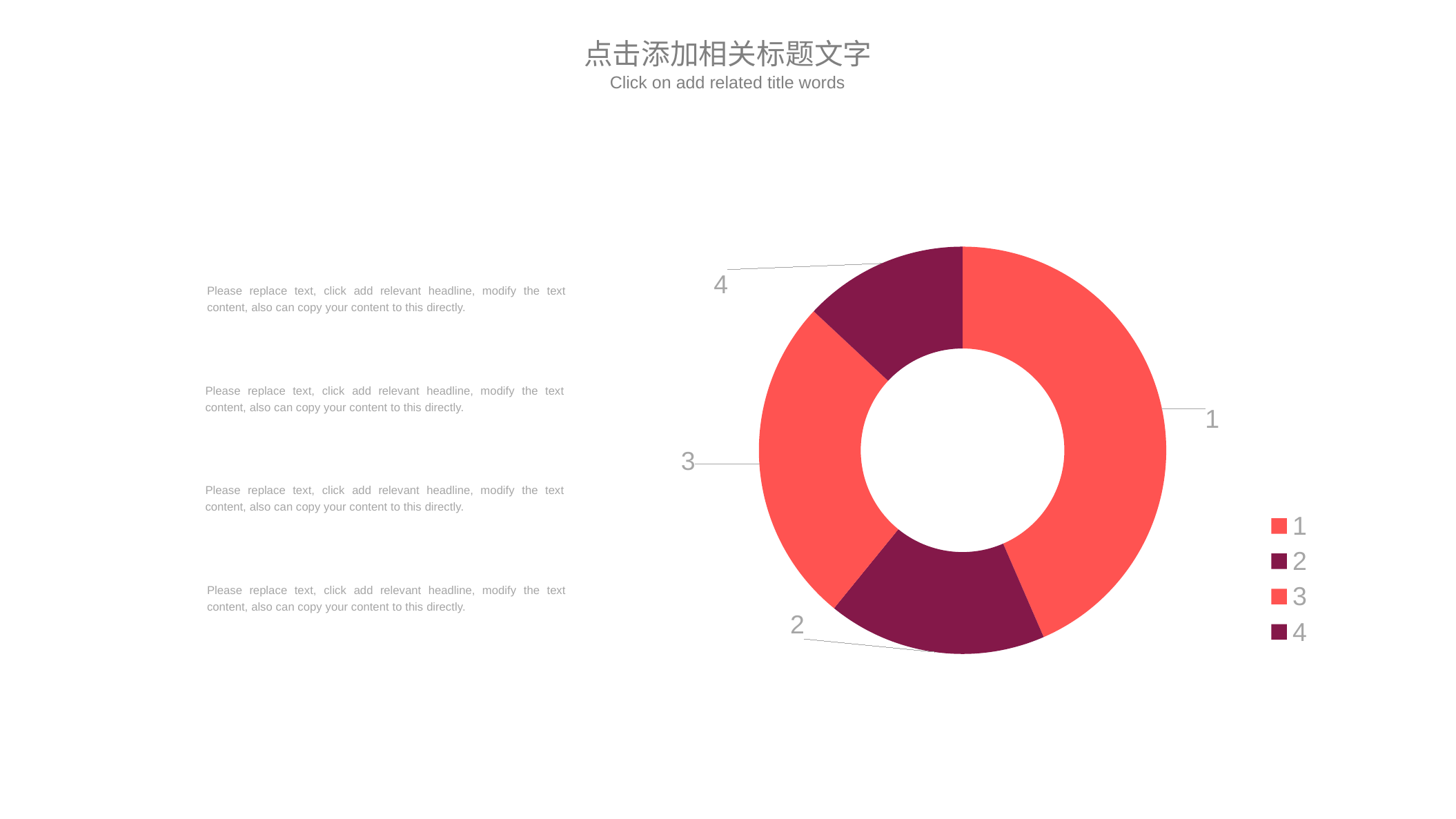
What are the legend entries of the chart, in order? 1, 2, 3, 4 How many entries does the legend list? 4 Which slice is larger, 2 or 3? 3 What colour is slice 2 in the doughnut chart? Dark purple Which slice is larger, 1 or 3? 1 What kind of chart is shown on the slide? Doughnut chart Which slice is larger, 3 or 4? 3 How many slices does the doughnut chart have? 4 Which slice is the smallest in the doughnut chart? 4 Which slice is the largest in the doughnut chart? 1